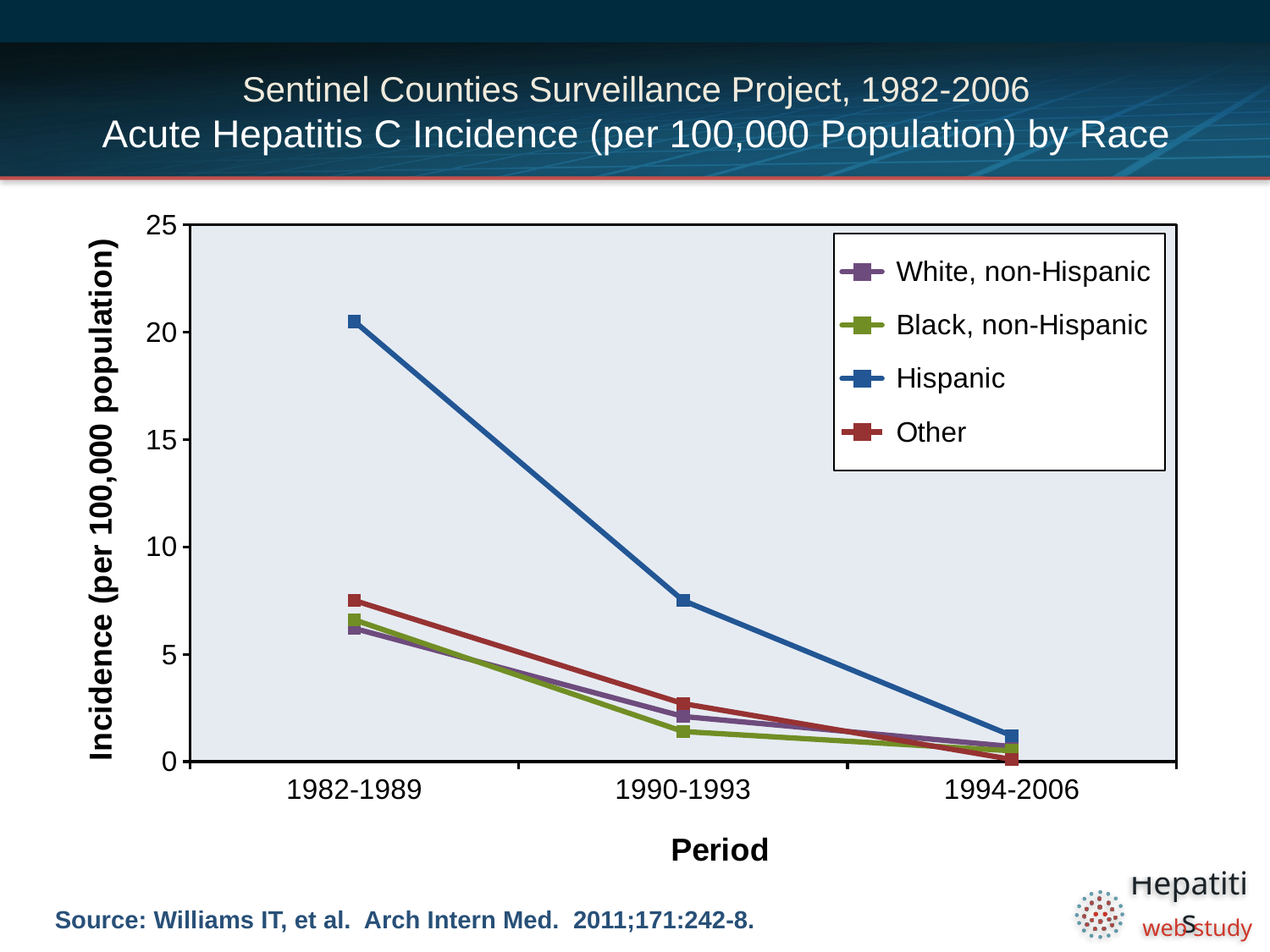
Is the value for Hispanic in 1982-1989 greater or less than 15? greater Is the value for Hispanic in 1990-1993 greater or less than 5? greater In the 1990-1993 period, which is larger, the value for Hispanic or the value for Other? Hispanic Which race group has the highest incidence in the 1982-1989 period? Hispanic Does the incidence for Hispanic rise or fall across the periods from 1982-1989 to 1994-2006? fall Is the value for Other in 1982-1989 greater or less than 5? greater How many periods are shown on the x axis? 3 What is the title of the y axis? Incidence (per 100,000 population) What kind of chart is shown on the slide? line chart How many series does the legend list? 4